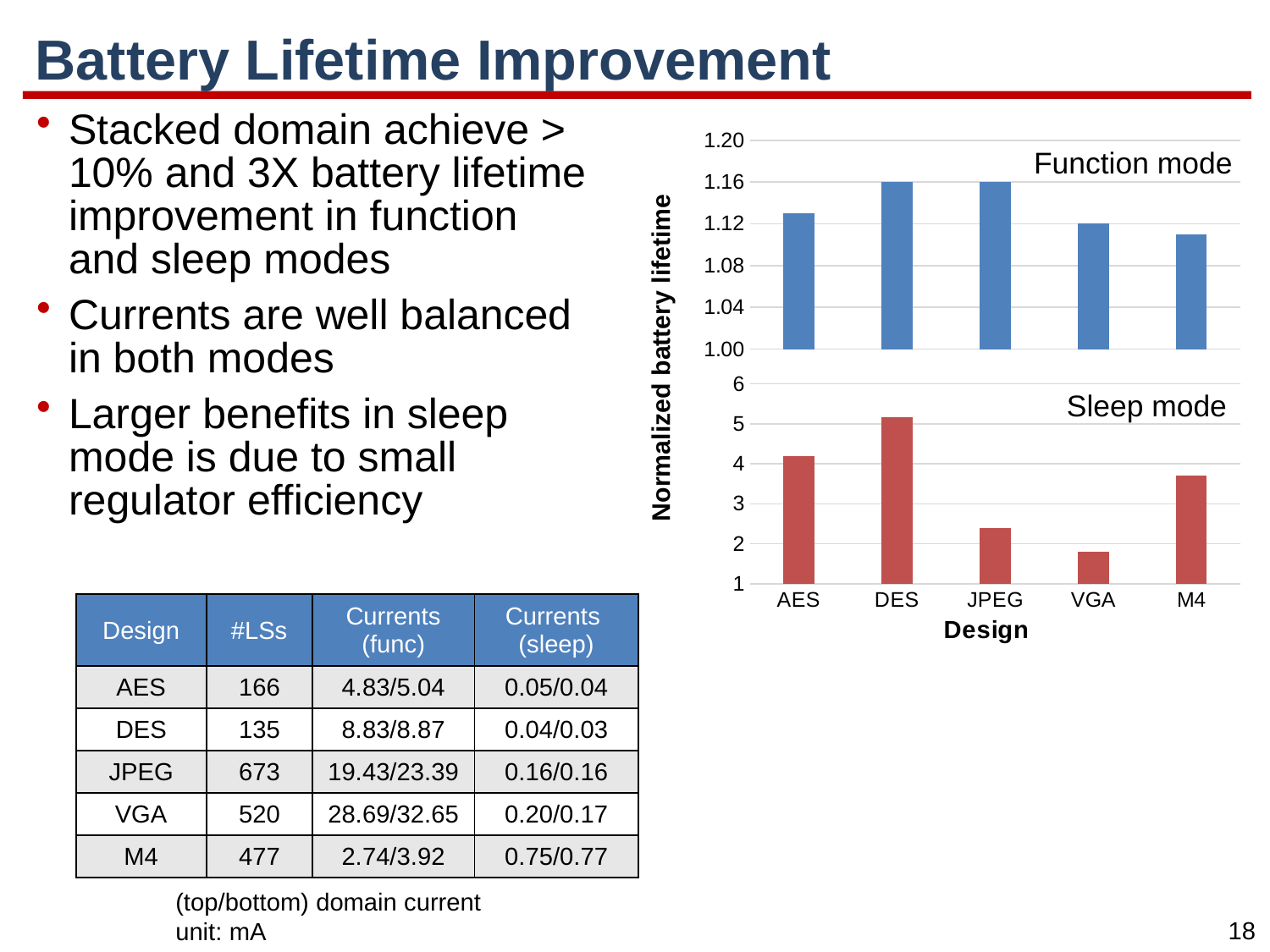
In the Sleep mode chart, which has the larger normalized battery lifetime, AES or JPEG? AES In the Sleep mode chart, is the value for VGA greater or less than 2? less How many designs are shown on the x axis of the Function mode chart? 5 In the Sleep mode chart, is the value for DES greater or less than 5? greater What is the label on the shared vertical axis of the charts? Normalized battery lifetime In the Sleep mode chart, which design has the lowest normalized battery lifetime? VGA In the Function mode chart, what is the normalized battery lifetime for DES? 1.16 In the Function mode chart, what is the normalized battery lifetime for VGA? 1.12 What kind of chart is the Sleep mode chart? bar chart In the Sleep mode chart, which design has the highest normalized battery lifetime? DES In the Sleep mode chart, is the value for M4 greater or less than 3? greater